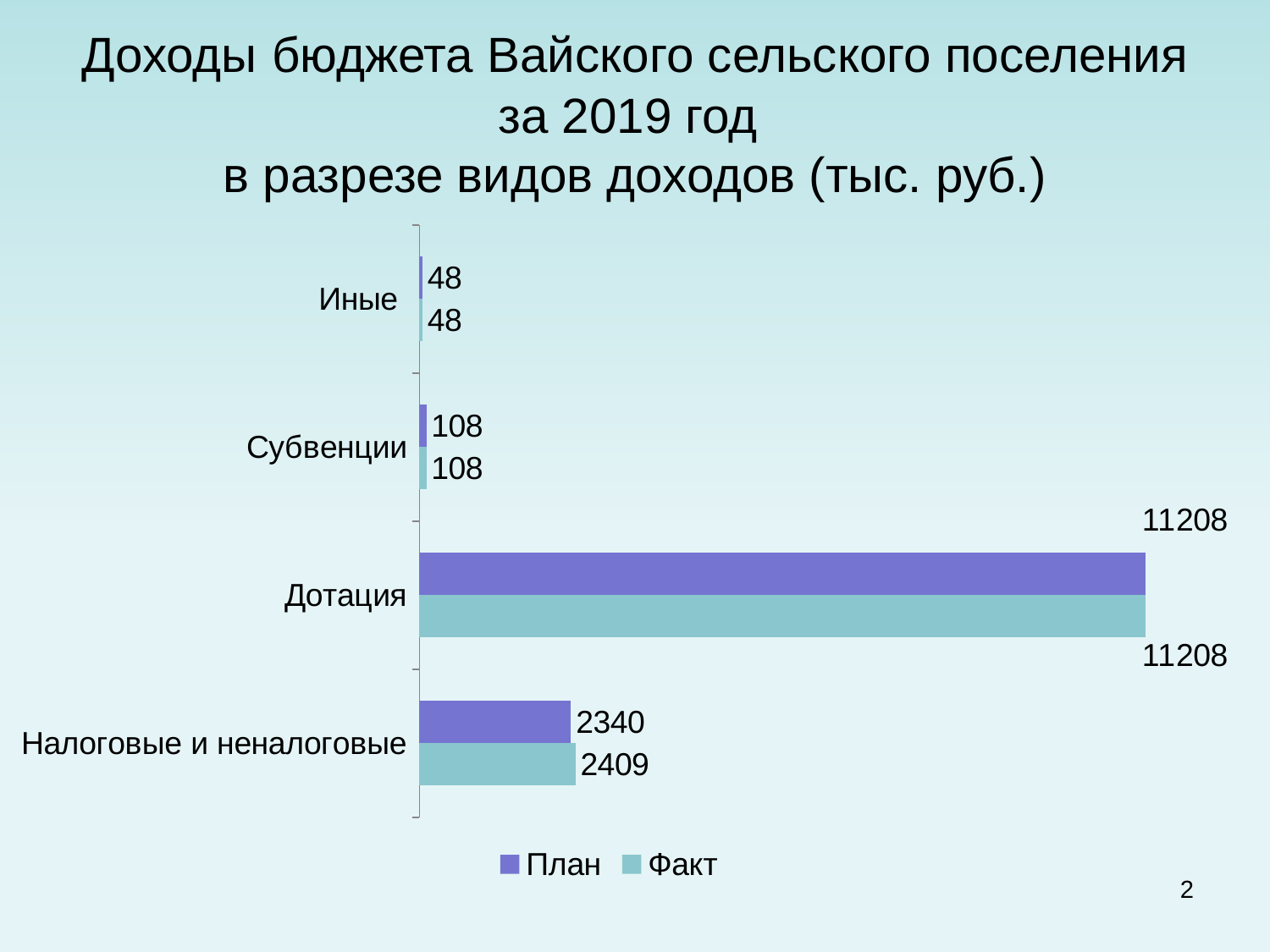
What is the Факт value for Иные? 48 What is the План value for Субвенции? 108 Which category has the lowest План value? Иные Which is larger for Налоговые и неналоговые, the План value or the Факт value? Факт What is the Факт value for Налоговые и неналоговые? 2409 How many series does the legend list? 2 What is the difference between the Факт and План values for Налоговые и неналоговые? 69 What are the two series named in the legend? План and Факт What kind of chart is shown on the slide? Bar chart What is the План value for Дотация? 11208 How many categories are shown on the chart? 4 Which category has the highest Факт value? Дотация